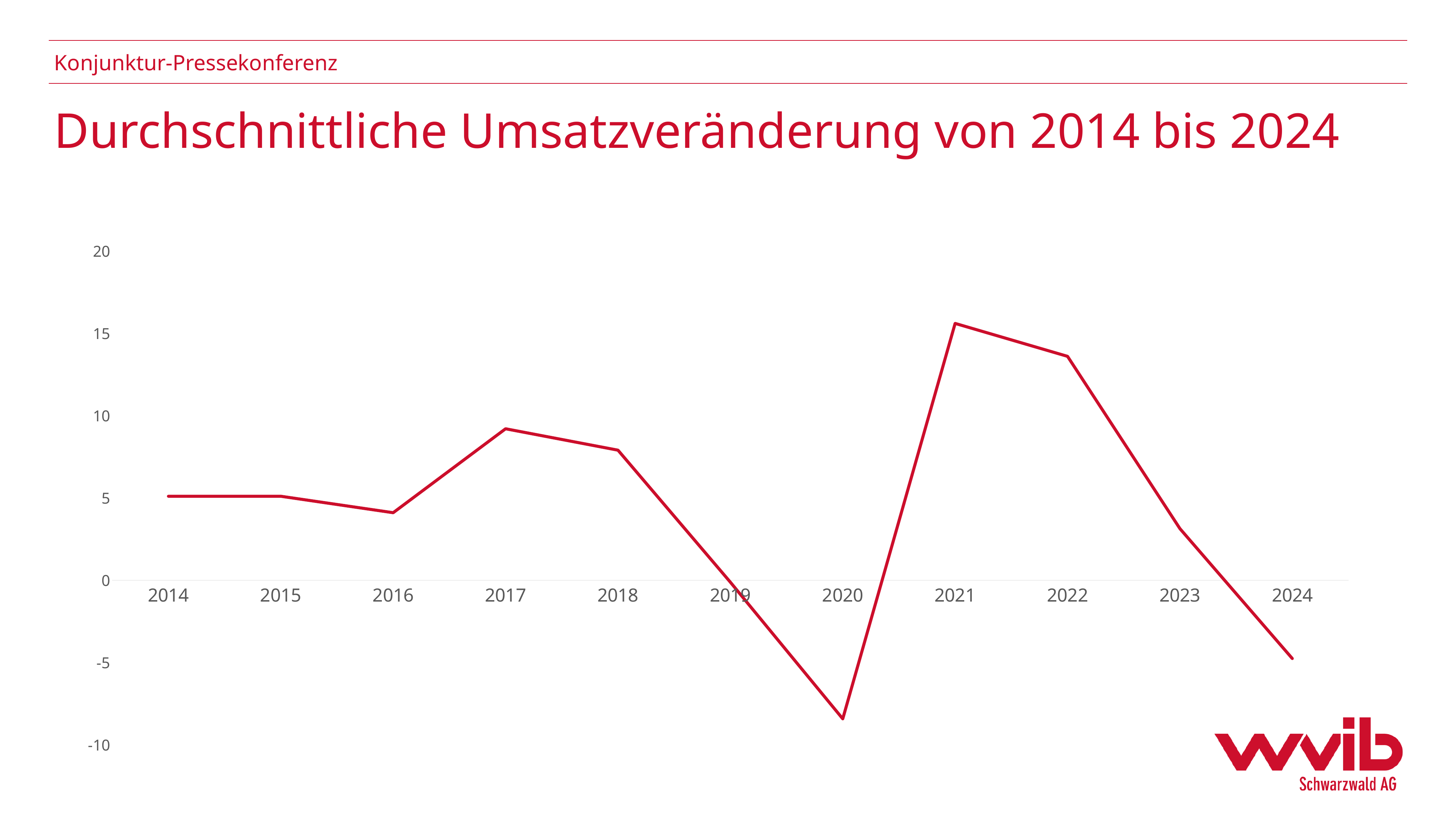
Which year has the highest value? 2021 Is the value for 2024 greater or less than 0? less Does the line rise or fall from 2021 to 2024? fall Which year has the lowest value? 2020 What kind of chart is shown on the slide? line chart Which is larger, the value for 2017 or the value for 2016? 2017 Is the value for 2017 greater or less than 10? less Is the value for 2021 greater or less than 15? greater What is the title of the chart? Durchschnittliche Umsatzveränderung von 2014 bis 2024 How many years are plotted along the x axis? 11